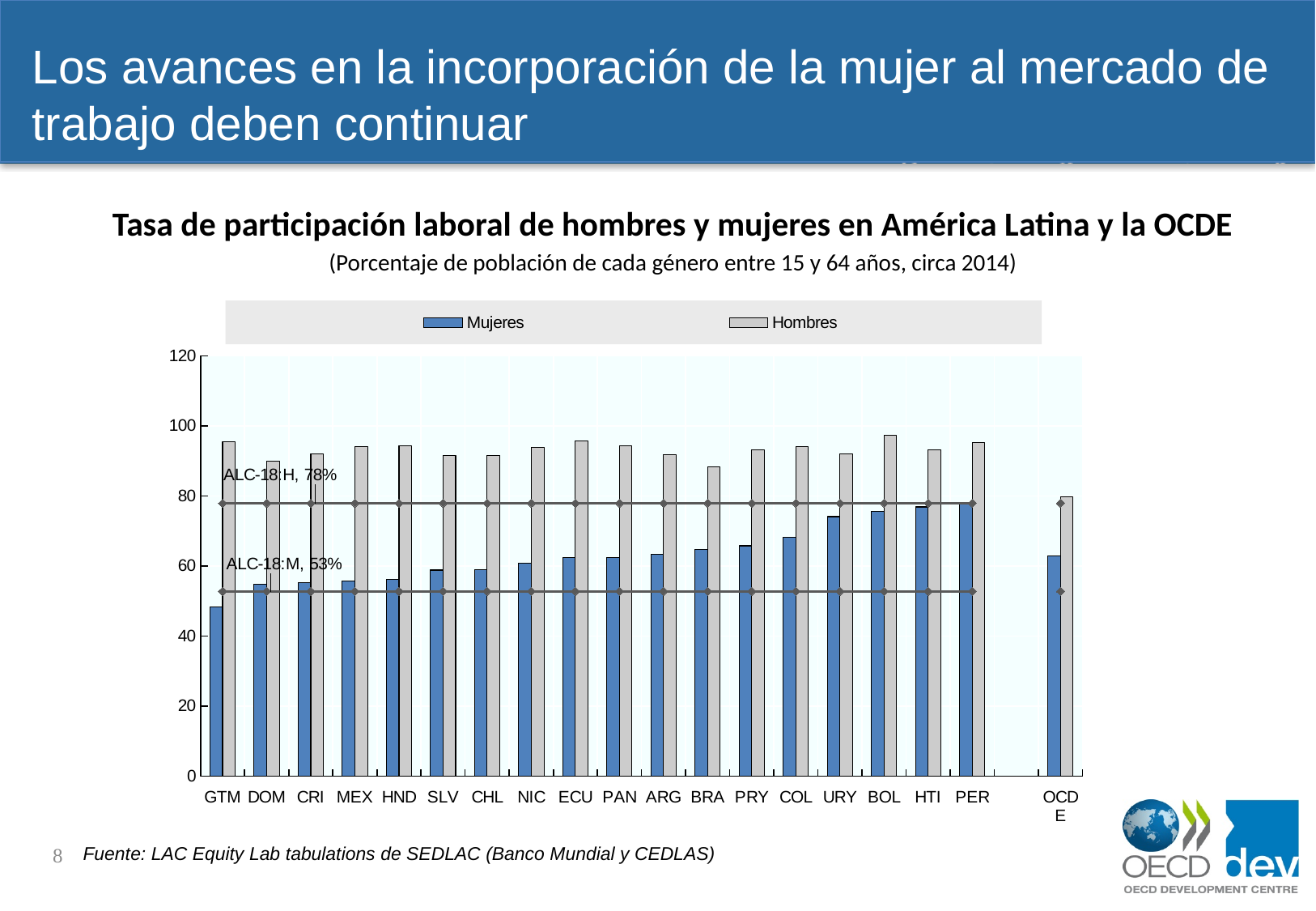
Do the Mujeres values rise or fall moving from GTM to PER along the x axis? rise Is the Hombres value for BRA greater or less than 80? greater How many countries or groups are shown on the x axis? 19 Which country has the lowest Mujeres (women) participation rate? GTM How many series does the legend list? 2 Which category has the lowest Hombres (men) participation rate? OCDE Which colour represents the Mujeres series in the legend? blue Which is larger, the Mujeres value for GTM or the Mujeres value for PER? PER What kind of chart is shown on the slide? bar chart What value is given for the ALC-18 reference line for men (ALC-18:H)? 78% What value is given for the ALC-18 reference line for women (ALC-18:M)? 53% Is the Mujeres value for GTM greater or less than 60? less